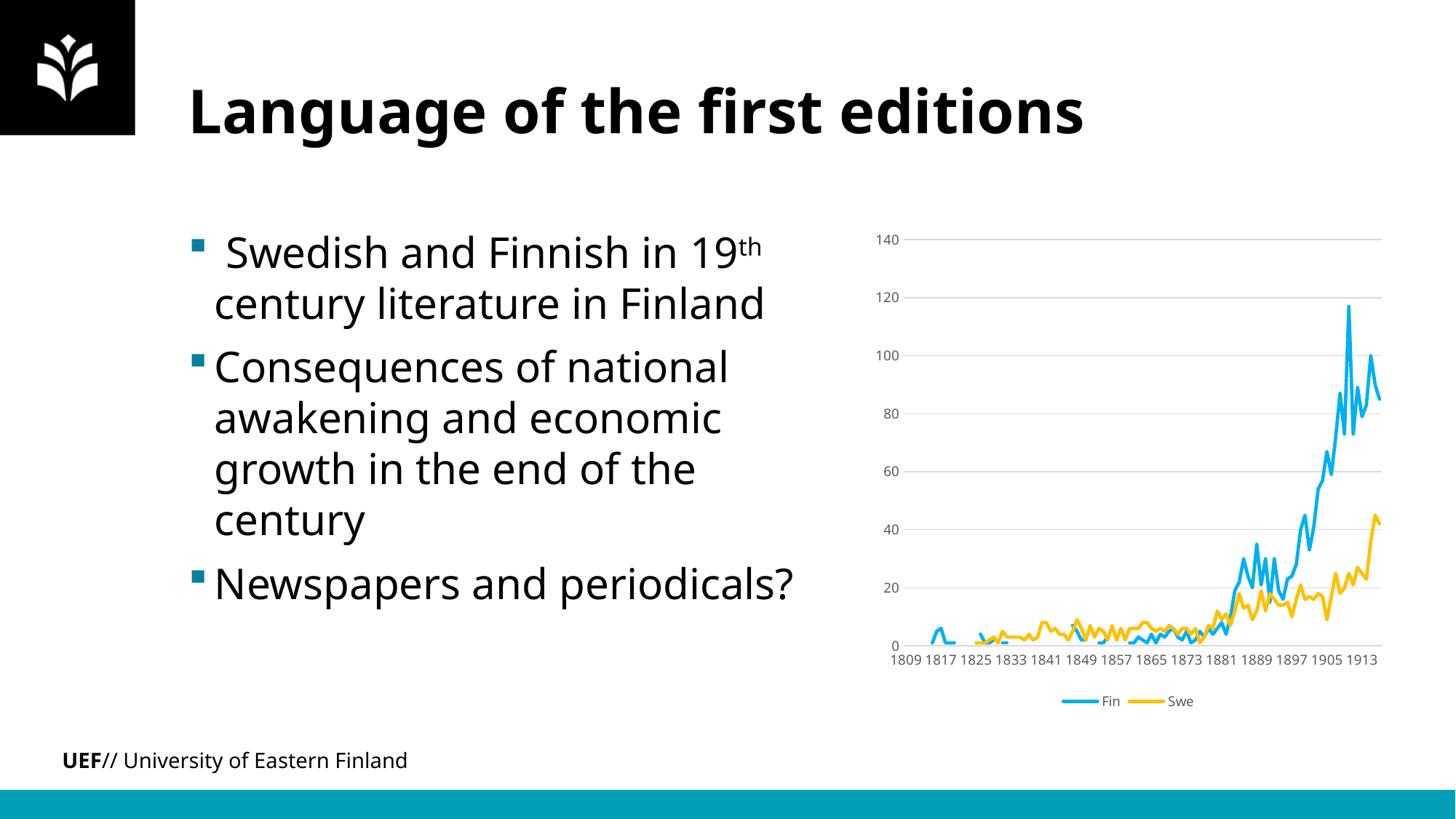
Which colour is used for the Fin series in the chart? blue Do the values of the Fin series generally rise or fall from 1809 to 1913? rise Which series reaches the highest value in the chart, Fin or Swe? Fin Is the value of the Fin series around 1913 greater or less than 60? greater What kind of chart is shown on the slide? line chart Is the value of the Swe series around 1841 greater or less than 20? less Is the peak value of the Swe series greater or less than 60? less How many series does the chart's legend list? 2 What are the two series named in the chart's legend? Fin and Swe Around 1849, which series has the higher value, Fin or Swe? Swe Around 1913, which series has the higher value, Fin or Swe? Fin